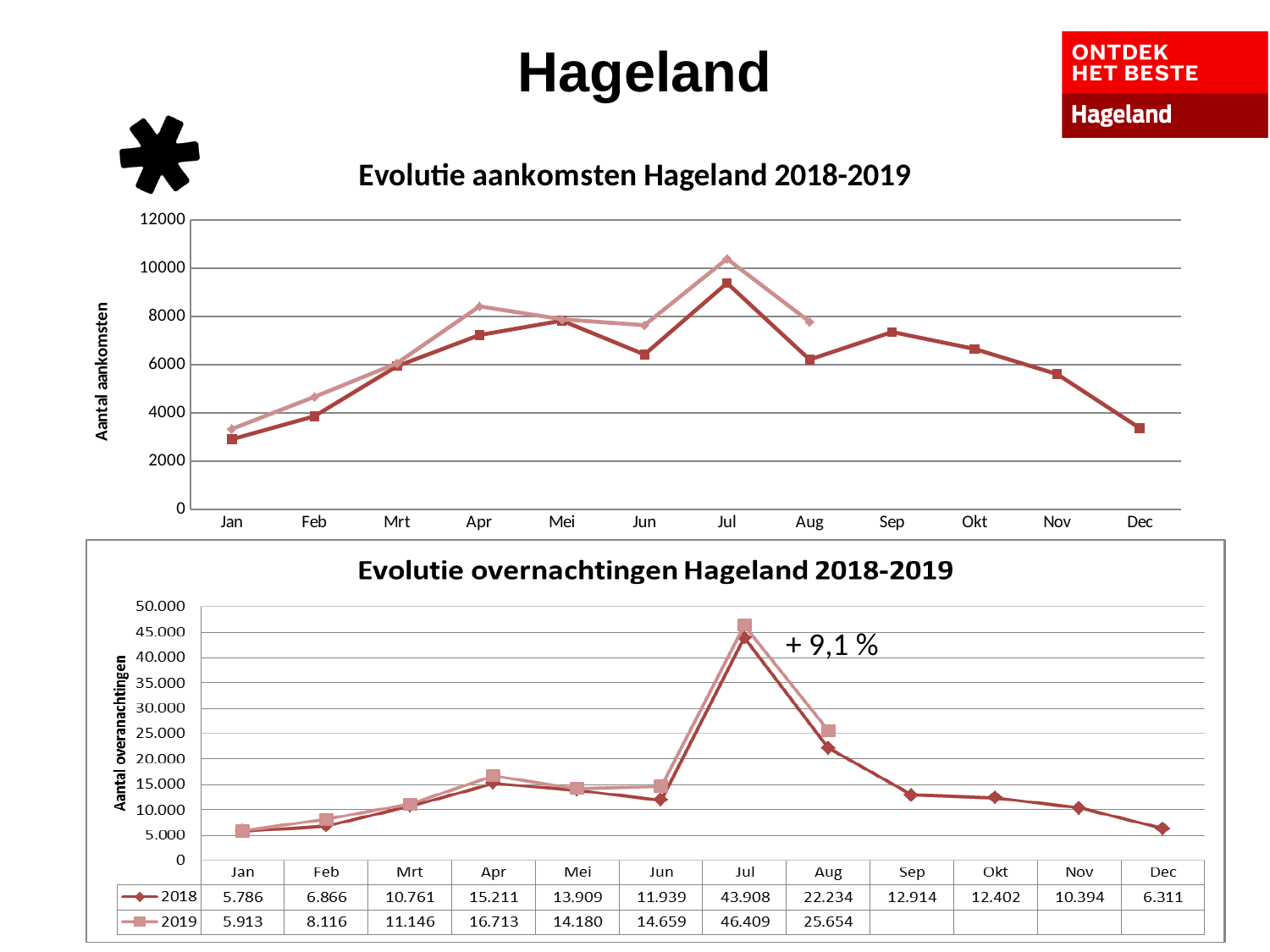
In the chart 'Evolutie overnachtingen Hageland 2018-2019', which is larger for Jun: the 2018 value or the 2019 value? 2019 In the chart 'Evolutie overnachtingen Hageland 2018-2019', what is the difference between the 2019 and 2018 values for Jul? 2.501 How many series does the legend of the chart 'Evolutie overnachtingen Hageland 2018-2019' list? 2 In the chart 'Evolutie overnachtingen Hageland 2018-2019', what is the 2019 value for Aug? 25.654 In the chart 'Evolutie overnachtingen Hageland 2018-2019', what is the 2018 value for Dec? 6.311 In the chart 'Evolutie overnachtingen Hageland 2018-2019', what is the 2018 value for Jul? 43.908 How many months are shown on the x axis of the chart 'Evolutie overnachtingen Hageland 2018-2019'? 12 What kind of chart is 'Evolutie aankomsten Hageland 2018-2019'? line chart In the chart 'Evolutie aankomsten Hageland 2018-2019', do the values rise or fall from Sep to Dec? fall In the chart 'Evolutie overnachtingen Hageland 2018-2019', which month has the lowest 2018 value? Jan In the chart 'Evolutie overnachtingen Hageland 2018-2019', which month has the highest 2018 value? Jul In the chart 'Evolutie aankomsten Hageland 2018-2019', is the value for Dec greater or less than 4000? less